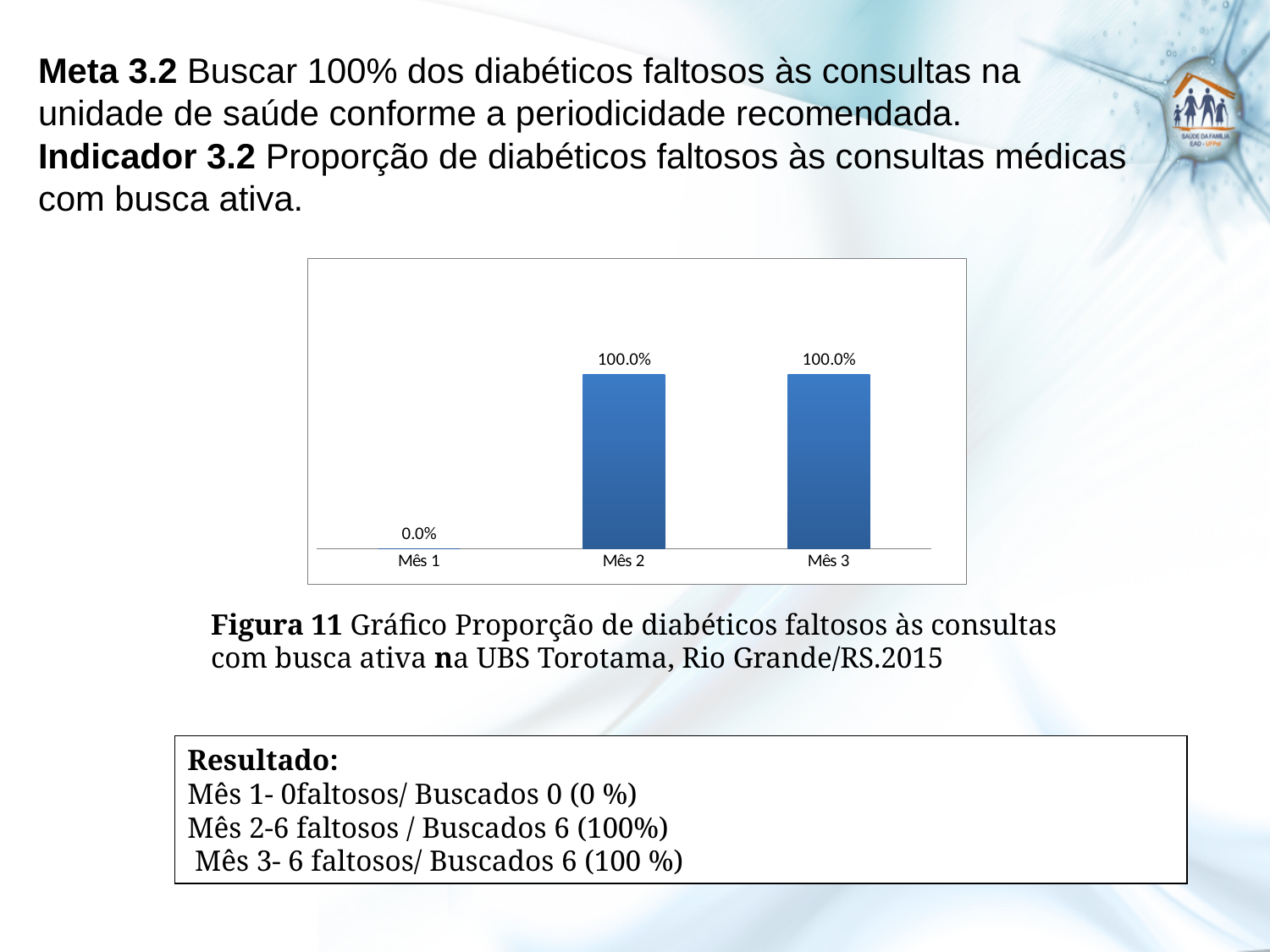
What colour are the bars in the chart? Blue Are the values for Mês 2 and Mês 3 equal? Yes What figure number is given in the caption below the chart? Figura 11 Do the values rise or fall from Mês 1 to Mês 2? Rise Which category has the lowest value? Mês 1 Which is larger, the value for Mês 1 or the value for Mês 3? Mês 3 What is the value for Mês 1? 0.0% What is the value for Mês 3? 100.0% What is the value for Mês 2? 100.0% What kind of chart is shown on the slide? Bar chart What is the difference between the values for Mês 2 and Mês 1? 100.0% How many categories are shown on the x axis of the chart? 3